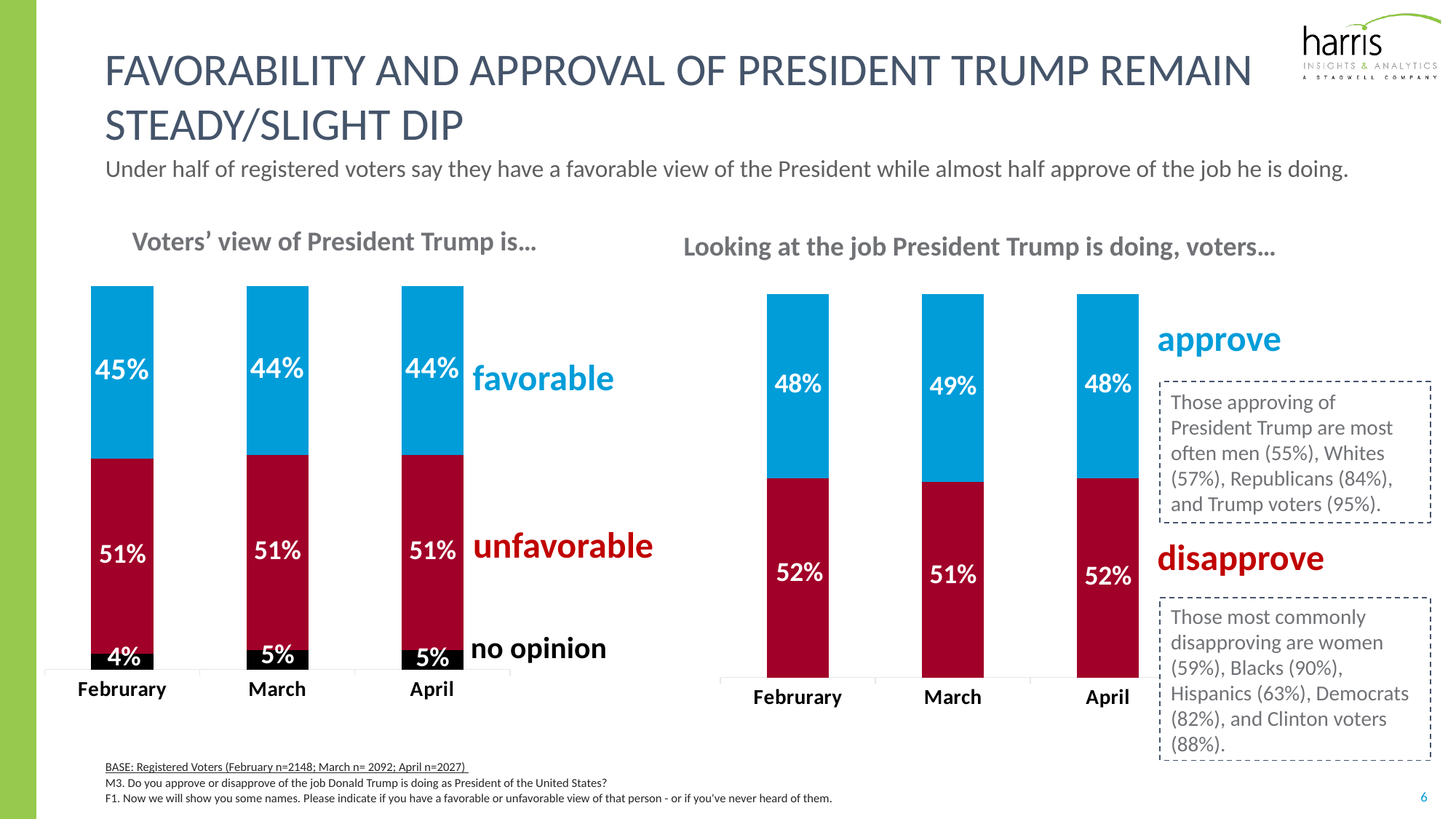
In the chart titled "Looking at the job President Trump is doing, voters…", what percentage of voters approved in March? 49% In the chart titled "Voters' view of President Trump is…", what percentage of voters had a favorable view in February? 45% In the chart titled "Voters' view of President Trump is…", which month had the lowest no opinion percentage? February In the chart titled "Voters' view of President Trump is…", what is the total of the favorable, unfavorable and no opinion percentages for February? 100% In the chart titled "Looking at the job President Trump is doing, voters…", what is the difference between the disapprove and approve percentages in February? 4% In the chart titled "Voters' view of President Trump is…", is the unfavorable percentage in April larger or smaller than the favorable percentage in April? larger In the chart titled "Voters' view of President Trump is…", what percentage of voters had no opinion in March? 5% In the chart titled "Voters' view of President Trump is…", which month had the highest favorable percentage? February What type of chart is the chart titled "Looking at the job President Trump is doing, voters…"? Stacked bar chart In the chart titled "Looking at the job President Trump is doing, voters…", what percentage of voters disapproved in April? 52% How many series are shown in the chart titled "Voters' view of President Trump is…"? 3 How many months are shown on the x axis of the chart titled "Looking at the job President Trump is doing, voters…"? 3